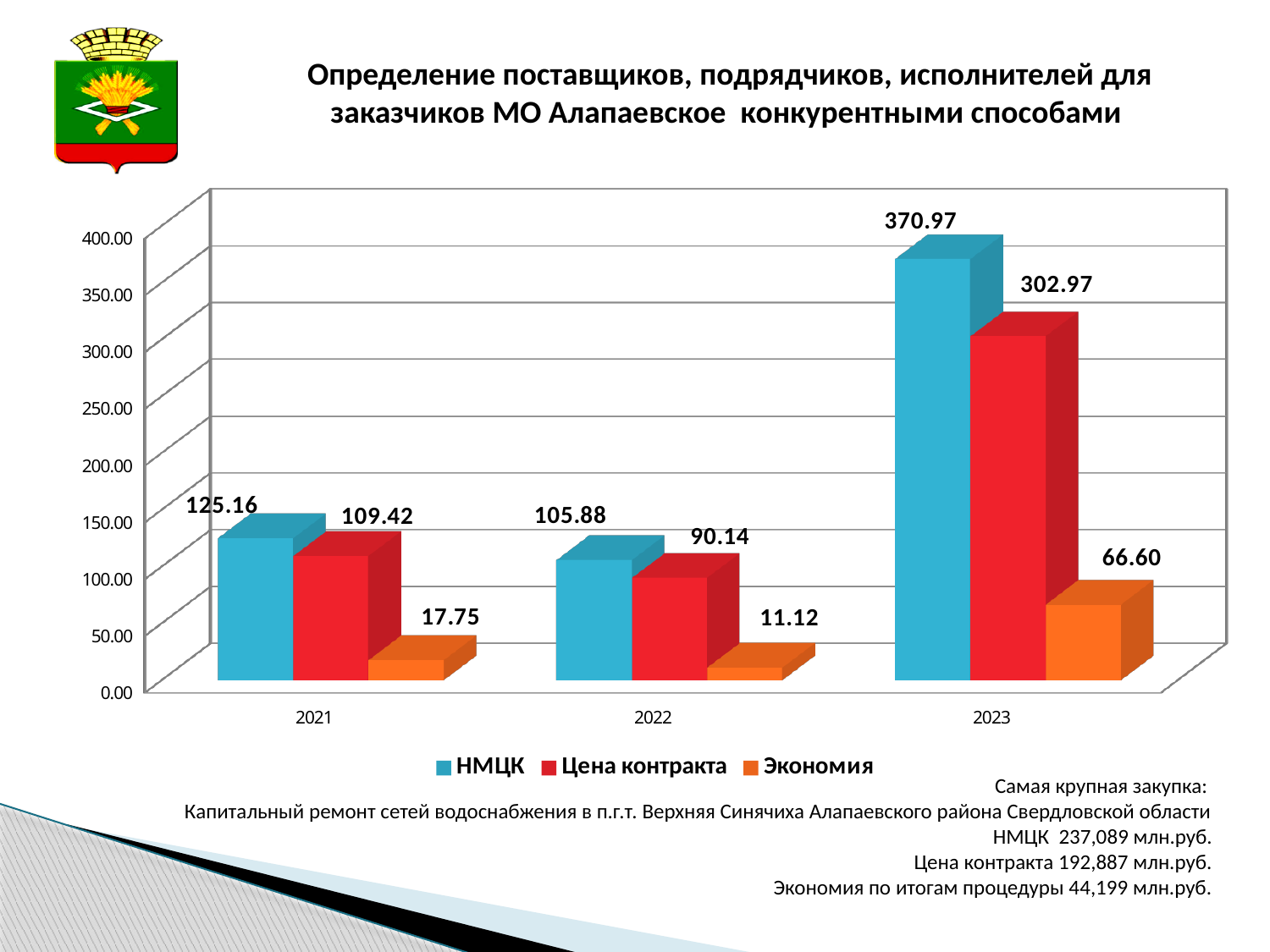
What is the difference between НМЦК and Цена контракта in 2023? 68.00 Which is larger: Цена контракта in 2021 or Цена контракта in 2022? Цена контракта in 2021 What is the value of Цена контракта for 2021? 109.42 How many years are shown on the x axis? 3 What is the value of Экономия for 2022? 11.12 In which year is the Экономия value highest? 2023 Which colour represents the Экономия series in the legend? Orange What is the value of НМЦК for 2022? 105.88 In which year is the НМЦК value lowest? 2022 How many series does the legend list? 3 What is the value of НМЦК for 2023? 370.97 What kind of chart is shown on the slide? Bar chart